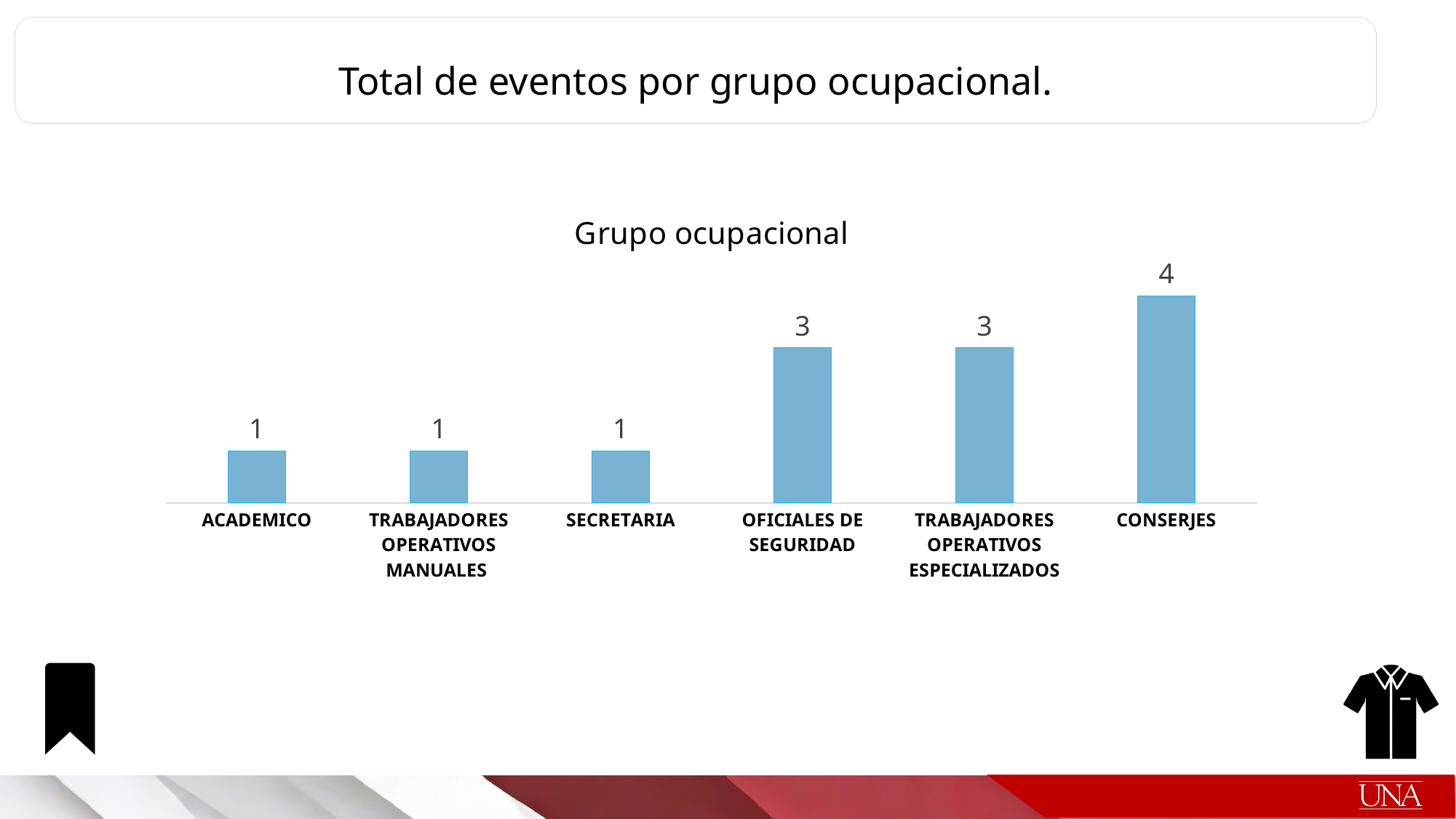
What is the title of the chart? Grupo ocupacional How many categories have a value of 1? 3 What is the difference between the values for CONSERJES and SECRETARIA? 3 What is the difference between the values for OFICIALES DE SEGURIDAD and TRABAJADORES OPERATIVOS MANUALES? 2 What kind of chart is shown on the slide? Bar chart What is the value for OFICIALES DE SEGURIDAD? 3 How many categories are shown on the x axis? 6 What is the value for TRABAJADORES OPERATIVOS ESPECIALIZADOS? 3 What is the value for ACADEMICO? 1 Which is larger, the value for CONSERJES or the value for OFICIALES DE SEGURIDAD? CONSERJES Which category has the highest value? CONSERJES What is the value for CONSERJES? 4